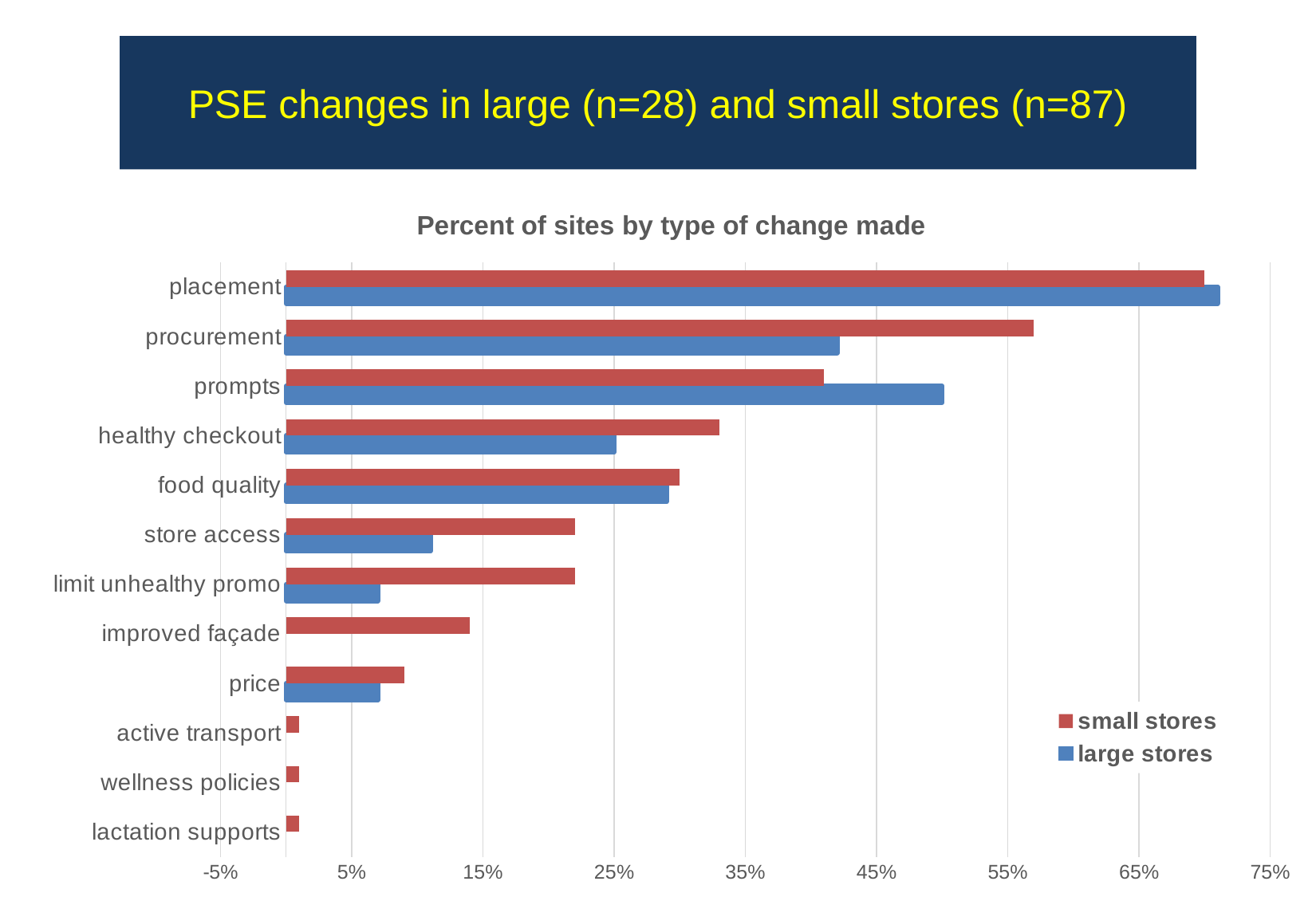
Is the value for large stores in the prompts category greater or less than 45%? greater For store access, which series has the larger value, small stores or large stores? small stores Is the value for large stores in the store access category greater or less than 15%? less How many categories (types of change) are shown on the chart? 12 For prompts, which series has the larger value, small stores or large stores? large stores What is the title of the chart? Percent of sites by type of change made Is the value for small stores in the healthy checkout category greater or less than 25%? greater For procurement, which series has the larger value, small stores or large stores? small stores How many series does the legend list? 2 Which category has the highest value for large stores? placement Which category has the highest value for small stores? placement What kind of chart is shown on the slide? bar chart